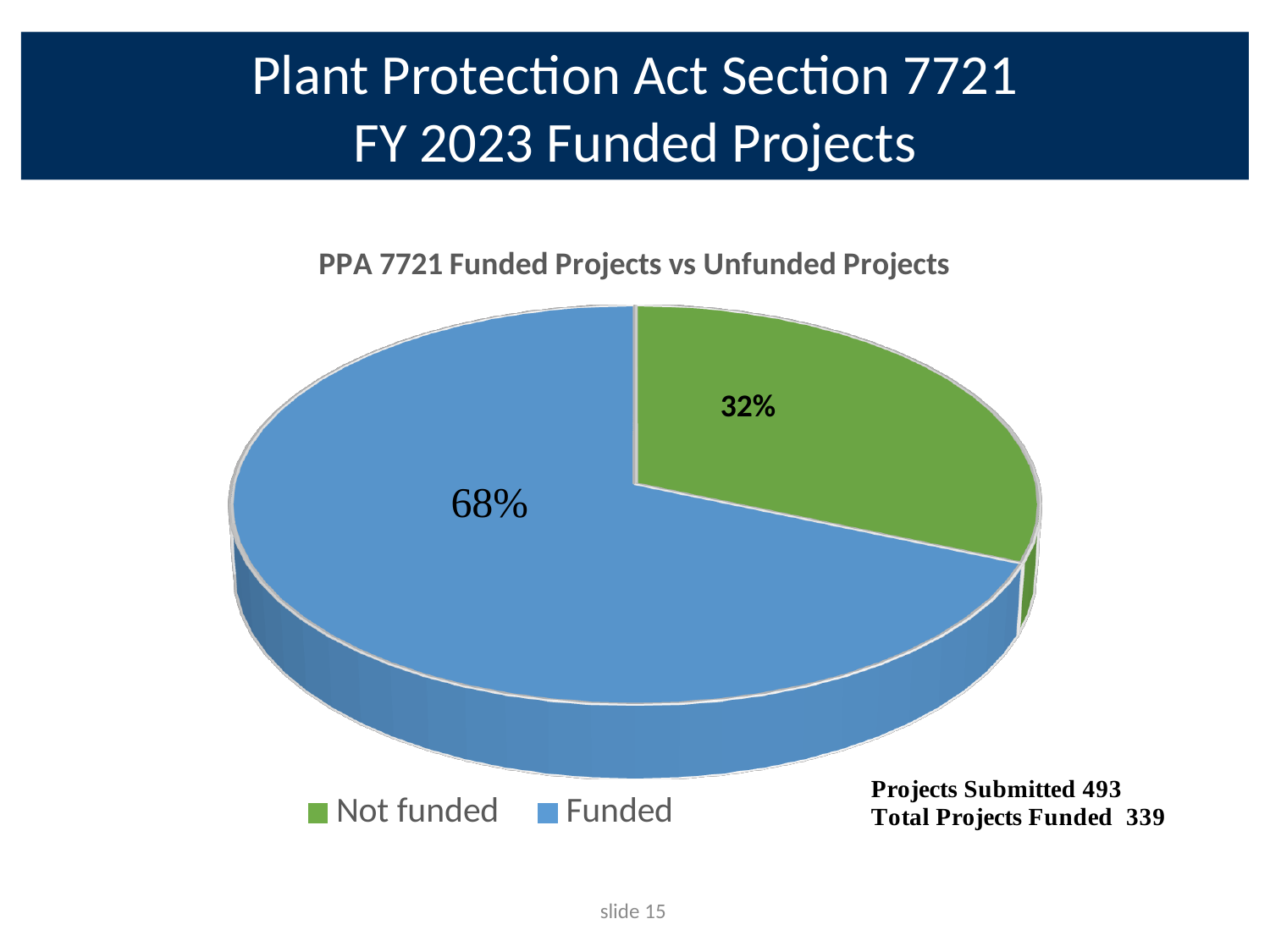
What is the difference in percentage points between the Funded and Not funded slices? 36 What percentage of projects were funded? 68% What colour represents the Not funded slice? Green Is the Funded share larger or smaller than the Not funded share? Larger Which category has the larger share of the pie? Funded What percentage of projects were not funded? 32% What share of the pie does the Funded slice represent? 68% How many entries does the legend list? 2 How many slices does the pie chart have? 2 What is the title of the chart? PPA 7721 Funded Projects vs Unfunded Projects What type of chart is shown on the slide? Pie chart Which category has the smaller share of the pie? Not funded